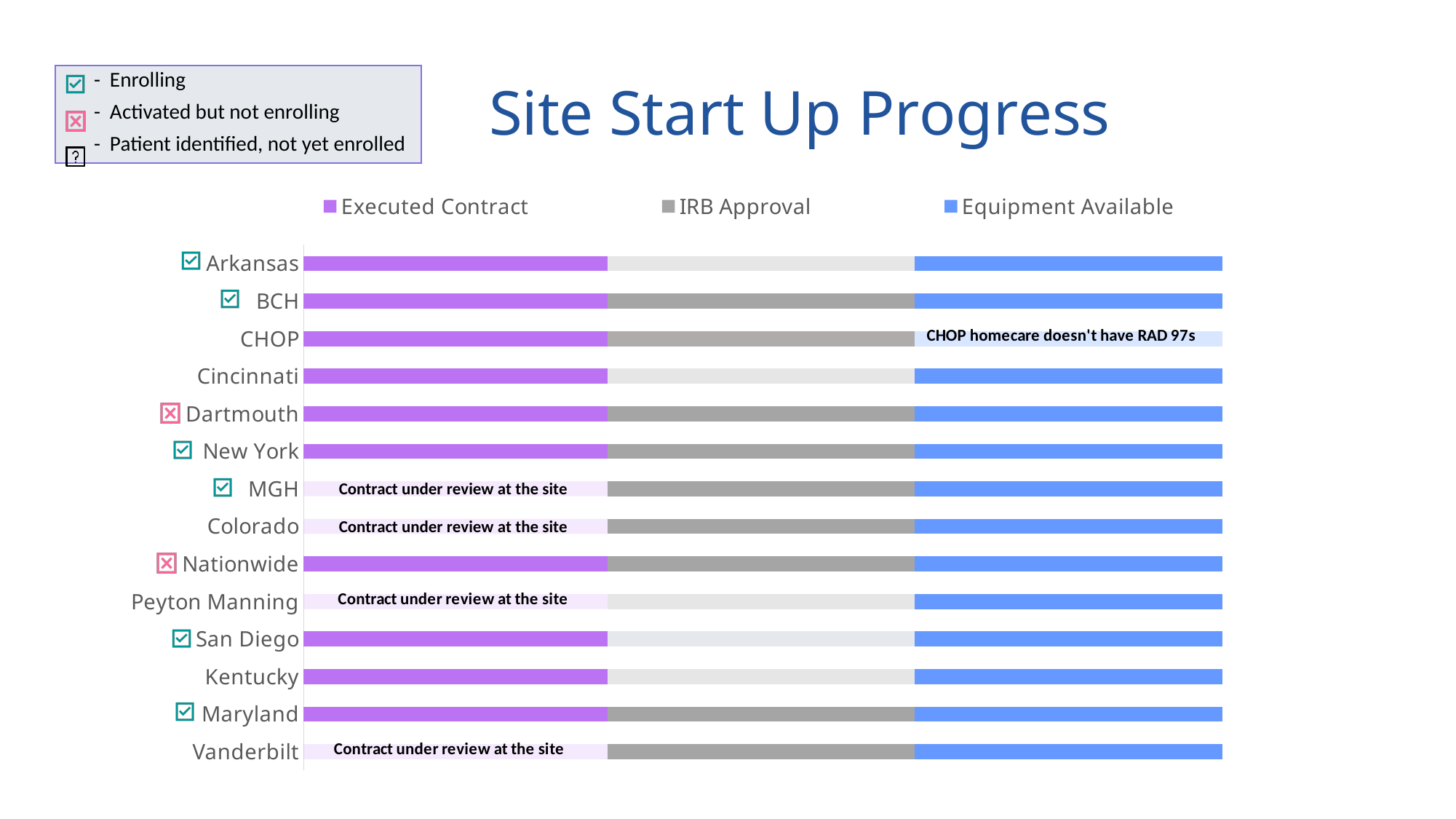
What text is shown in place of the Executed Contract bar for MGH? Contract under review at the site What is the title of the slide? Site Start Up Progress What kind of chart is shown on the slide? bar chart Which series is shown in purple? Executed Contract Which sites show the note "Contract under review at the site"? MGH, Colorado, Peyton Manning, Vanderbilt How many series does the chart legend list? 3 How many sites show the note "Contract under review at the site"? 4 How many sites are listed on the chart? 14 What text is shown in place of the Equipment Available bar for CHOP? CHOP homecare doesn't have RAD 97s Which site is listed last (at the bottom) on the chart? Vanderbilt